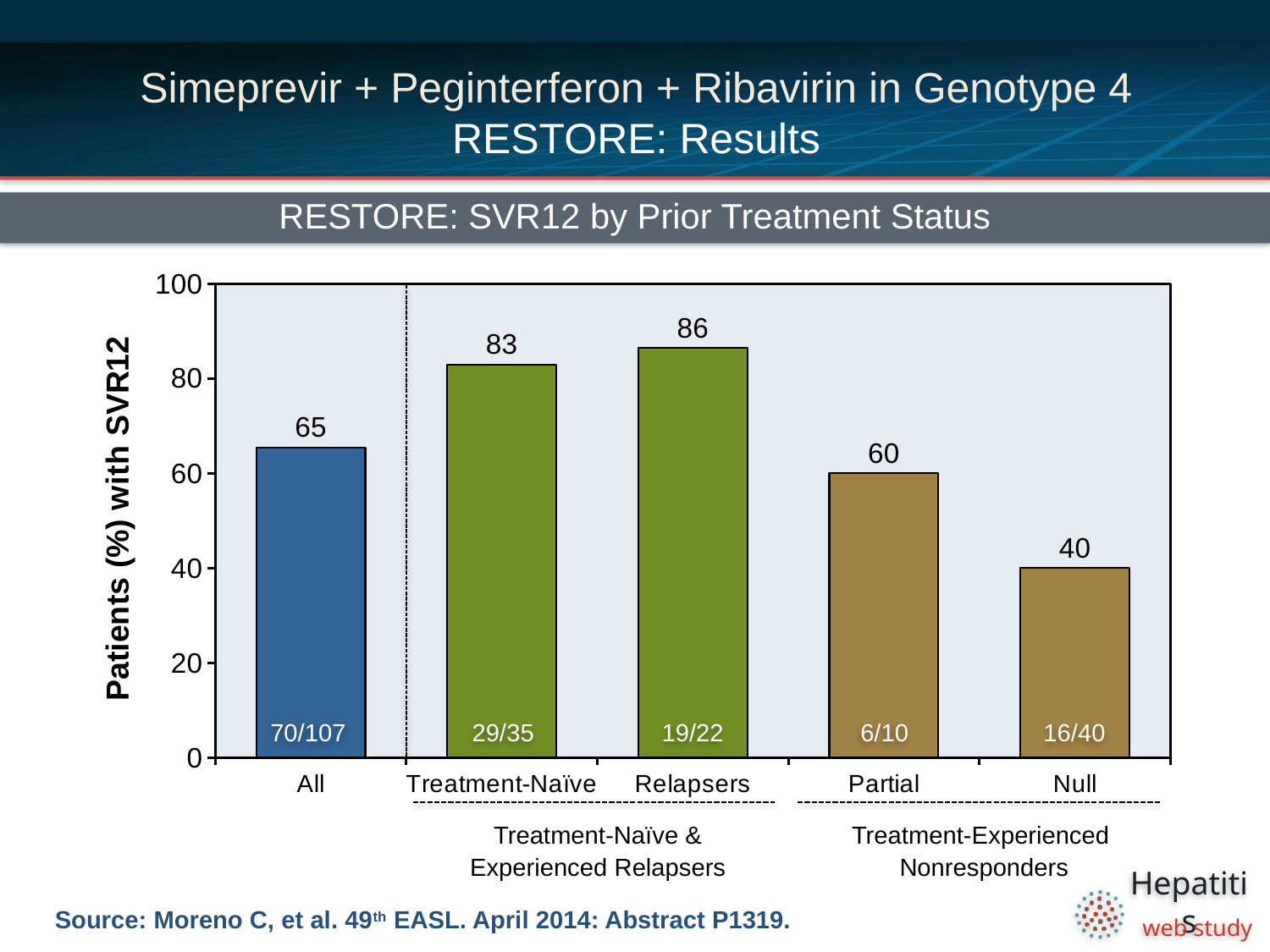
How many bars are shown in the chart? 5 Which has a higher SVR12 rate, Treatment-Naïve or Relapsers? Relapsers What fraction of patients is shown inside the Partial bar? 6/10 Which category has the highest SVR12 rate? Relapsers What is the label of the y-axis? Patients (%) with SVR12 What is the SVR12 rate (%) for Relapsers? 86 What is the SVR12 rate (%) for the All group? 65 What is the title of the chart? RESTORE: SVR12 by Prior Treatment Status Which category has the lowest SVR12 rate? Null What is the SVR12 rate (%) for the Null group? 40 What is the difference in SVR12 rate between Treatment-Naïve and Partial? 23 What type of chart is shown on the slide? Bar chart